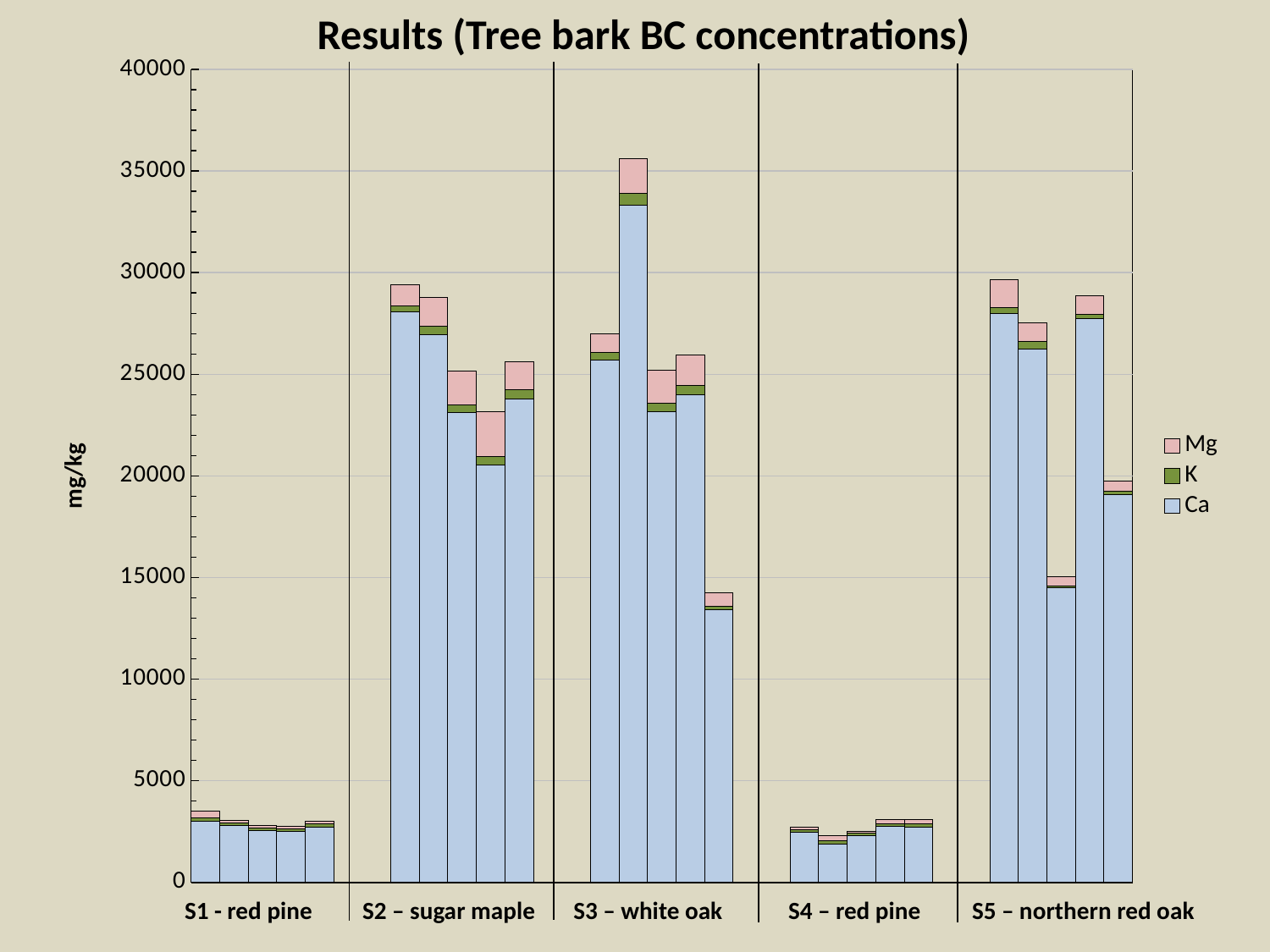
Which is larger, the tallest bar in S3 – white oak or the tallest bar in S2 – sugar maple? S3 – white oak What kind of chart is shown on the slide? stacked bar chart Is the shortest bar in the S3 – white oak group greater or less than 15000? less What is the title of the chart? Results (Tree bark BC concentrations) How many site groups are shown along the x axis? 5 How many bars are shown in the S3 – white oak group? 5 Which site group contains the tallest bar? S3 – white oak Are the bar totals for S1 - red pine greater or less than 5000? less What unit is shown on the y axis? mg/kg How many series does the legend list? 3 Is the tallest bar in the S3 – white oak group greater or less than 30000? greater Which series are listed in the legend? Mg, K, Ca